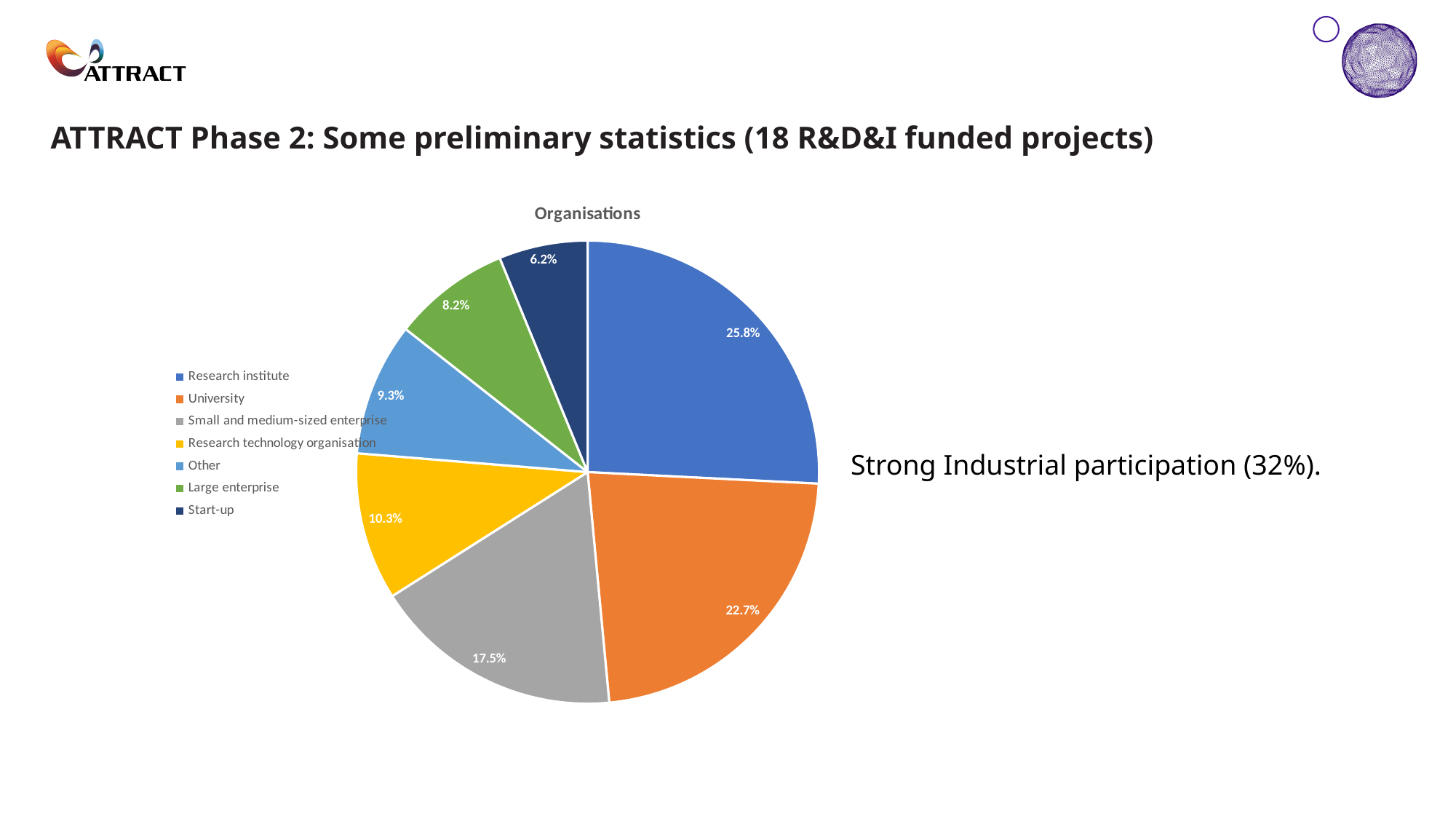
What share of the pie does Research institute have? 25.8% What share of the pie does Small and medium-sized enterprise have? 17.5% How many categories does the pie chart show? 7 What share of the pie does University have? 22.7% What type of chart is shown on the slide? pie chart What share of the pie does Start-up have? 6.2% Which is larger, the share for Other or the share for Large enterprise? Other What is the title of the chart? Organisations What is the difference in percentage points between Research institute and University? 3.1 What colour is the slice for Research technology organisation? yellow Which category has the largest slice of the pie? Research institute Which category has the smallest slice of the pie? Start-up